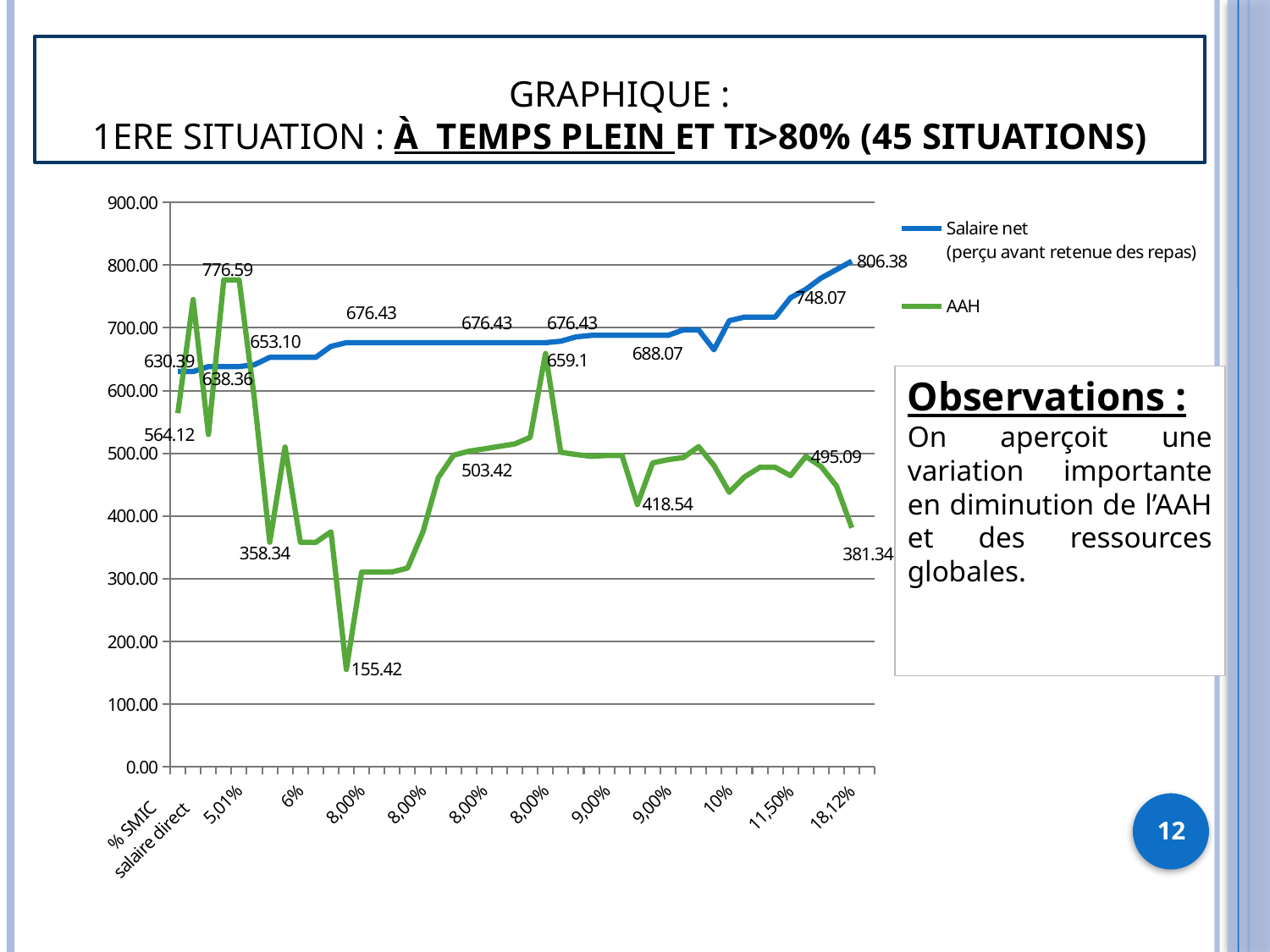
Is the lowest point of the AAH series greater or less than 200.00? less Does the Salaire net series generally rise or fall from left to right along the x axis? rise What is the value of the last labelled point of the Salaire net series, at the right end of the chart? 806.38 What is the first labelled value of the Salaire net series, at the left of the chart? 630.39 What are the two series named in the legend? Salaire net (perçu avant retenue des repas) and AAH What is the difference between the final labelled Salaire net value (806.38) and the final labelled AAH value (381.34)? 425.04 What kind of chart is shown on the slide? line chart What is the difference between the highest labelled AAH value (776.59) and the lowest labelled AAH value (155.42)? 621.17 What is the highest labelled value of the AAH series? 776.59 How many series does the legend list? 2 What is the value of the last labelled point of the AAH series, at the right end of the chart? 381.34 What is the lowest labelled value of the AAH series? 155.42